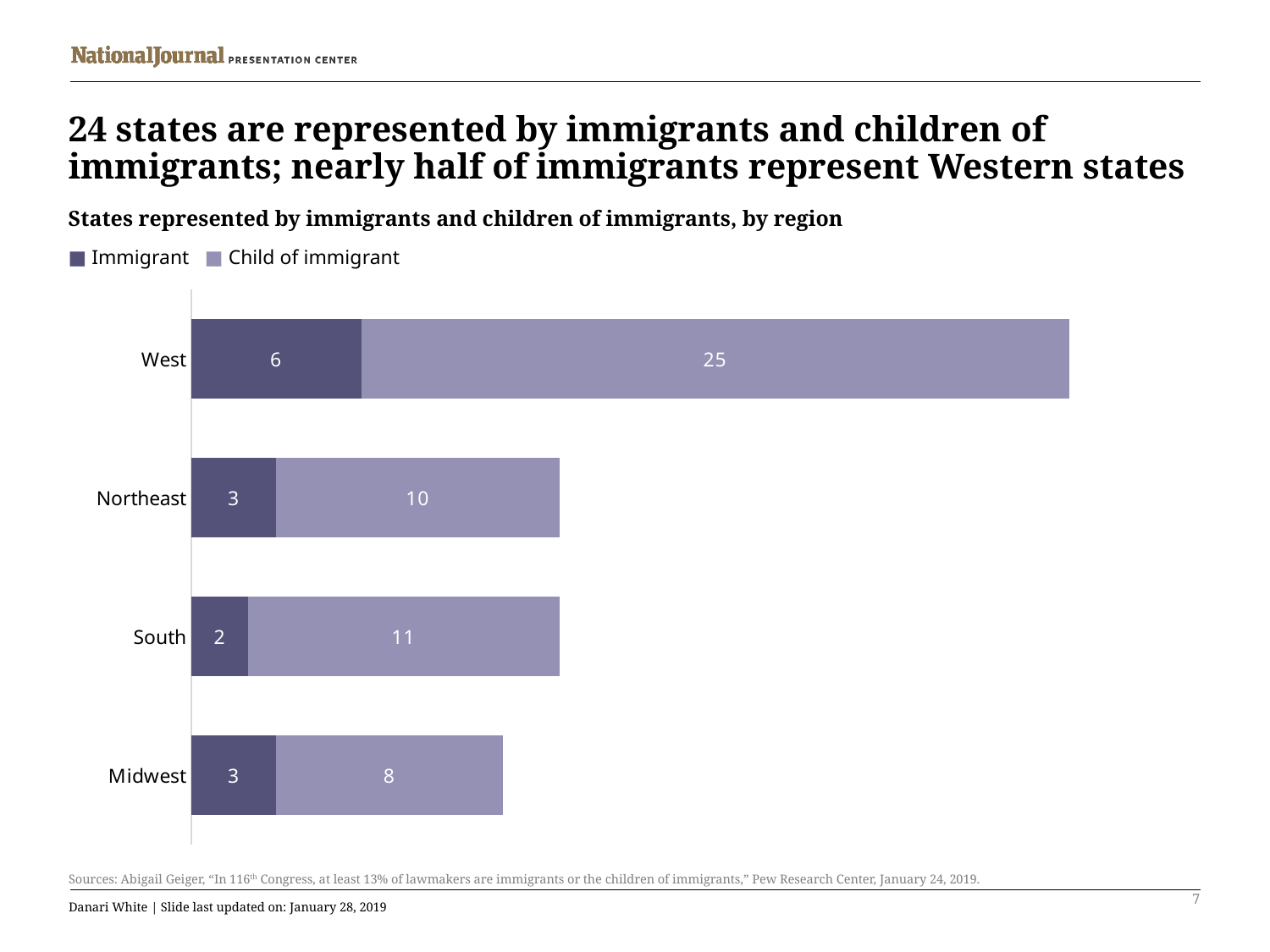
Which region has the lowest Immigrant value? South Which region has the highest Child of immigrant value? West What is the Child of immigrant value for the Midwest region? 8 What kind of chart is shown on the slide? Stacked bar chart What is the total of the stacked bar for the Northeast region? 13 What is the Child of immigrant value for the South region? 11 What is the total of the stacked bar for the West region? 31 What is the difference between the Child of immigrant values for West and Northeast? 15 How many series does the legend list? 2 How many regions are shown in the chart? 4 What is the Immigrant value for the West region? 6 Which is larger, the Child of immigrant value for South or for Midwest? South